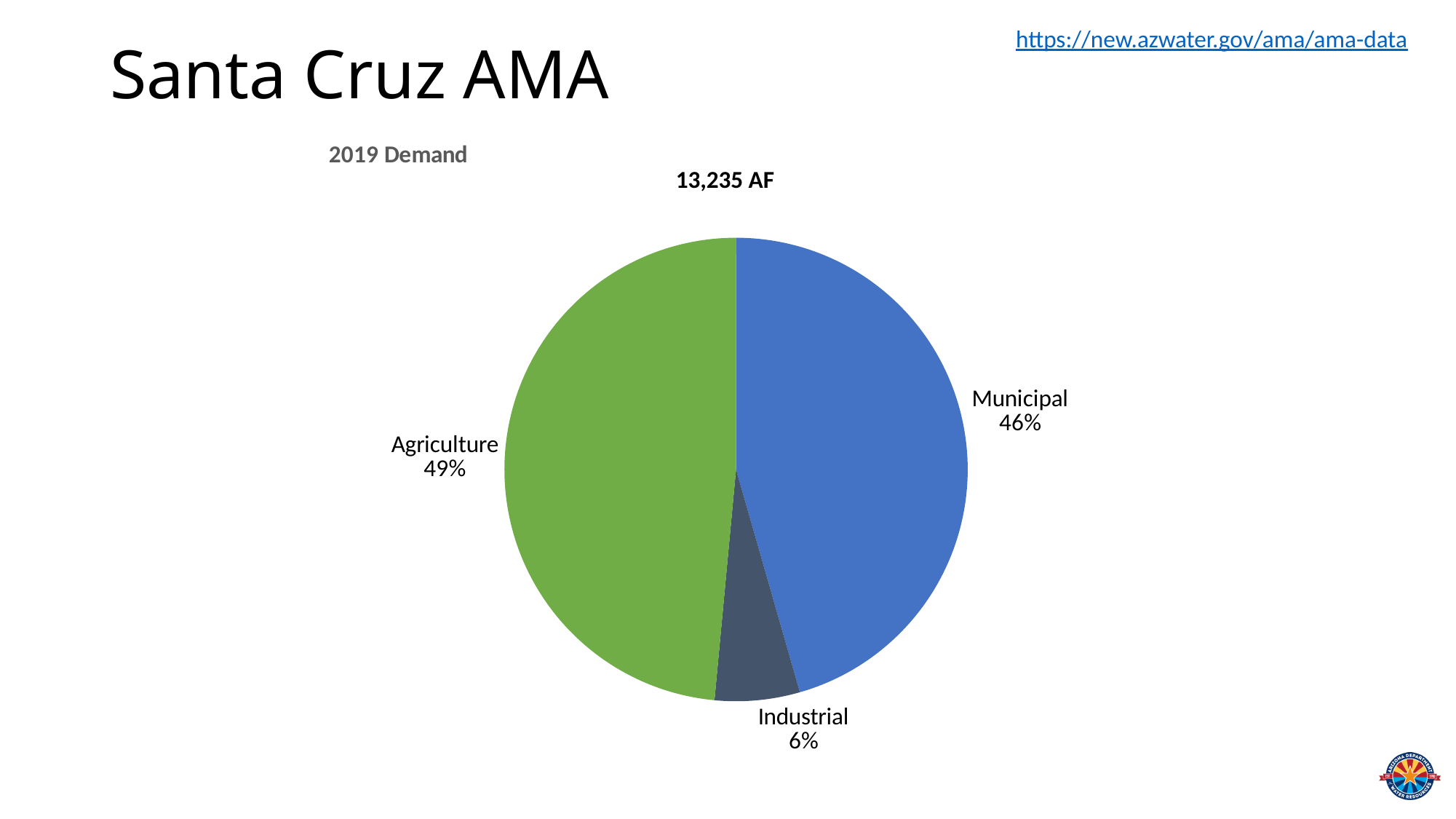
Which is larger, the Municipal share or the Industrial share? Municipal Which category has the smallest share of 2019 demand? Industrial What total demand in acre-feet is shown above the pie chart? 13,235 AF Which category has the largest share of 2019 demand? Agriculture What share of 2019 demand does Industrial account for? 6% What kind of chart is shown on the slide? Pie chart What is the title of the pie chart? 2019 Demand What share of 2019 demand does Municipal account for? 46% How many categories are shown in the pie chart? 3 What is the difference in percentage points between the Municipal and Industrial shares? 40 percentage points What is the difference in percentage points between the Agriculture and Municipal shares? 3 percentage points What share of 2019 demand does Agriculture account for? 49%